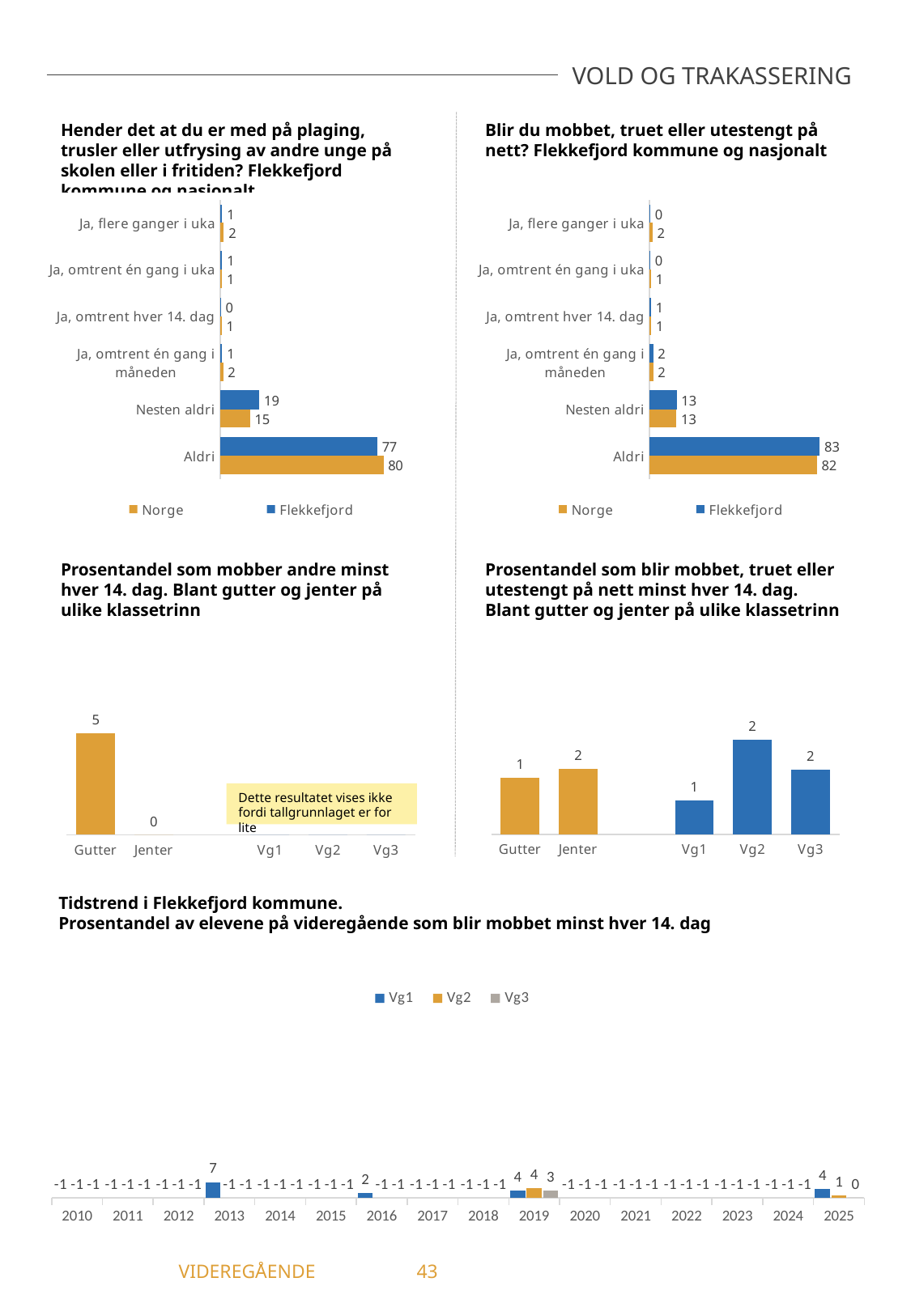
In the chart 'Blir du mobbet, truet eller utestengt på nett?', what is the value for Norge in the 'Aldri' category? 82 In the chart 'Hender det at du er med på plaging, trusler eller utfrysing av andre unge på skolen eller i fritiden?', what is the difference between Flekkefjord and Norge for 'Nesten aldri'? 4 In the chart 'Tidstrend i Flekkefjord kommune', what is the value for Vg1 in 2013? 7 In the chart 'Blir du mobbet, truet eller utestengt på nett?', what kind of chart is it? Bar chart In the chart 'Hender det at du er med på plaging, trusler eller utfrysing av andre unge på skolen eller i fritiden?', what is the value for Flekkefjord in the 'Aldri' category? 77 In the chart 'Prosentandel som blir mobbet, truet eller utestengt på nett minst hver 14. dag', what is the value for Vg2? 2 In the chart 'Prosentandel som mobber andre minst hver 14. dag', what is the value for Gutter? 5 In the chart 'Blir du mobbet, truet eller utestengt på nett?', which category has the highest value for Flekkefjord? Aldri In the chart 'Tidstrend i Flekkefjord kommune', what is the value for Vg3 in 2019? 3 In the chart 'Hender det at du er med på plaging, trusler eller utfrysing av andre unge på skolen eller i fritiden?', how many series does the legend list? 2 In the chart 'Prosentandel som mobber andre minst hver 14. dag', which is larger, Gutter or Jenter? Gutter In the chart 'Blir du mobbet, truet eller utestengt på nett?', how many categories are shown on the axis? 6